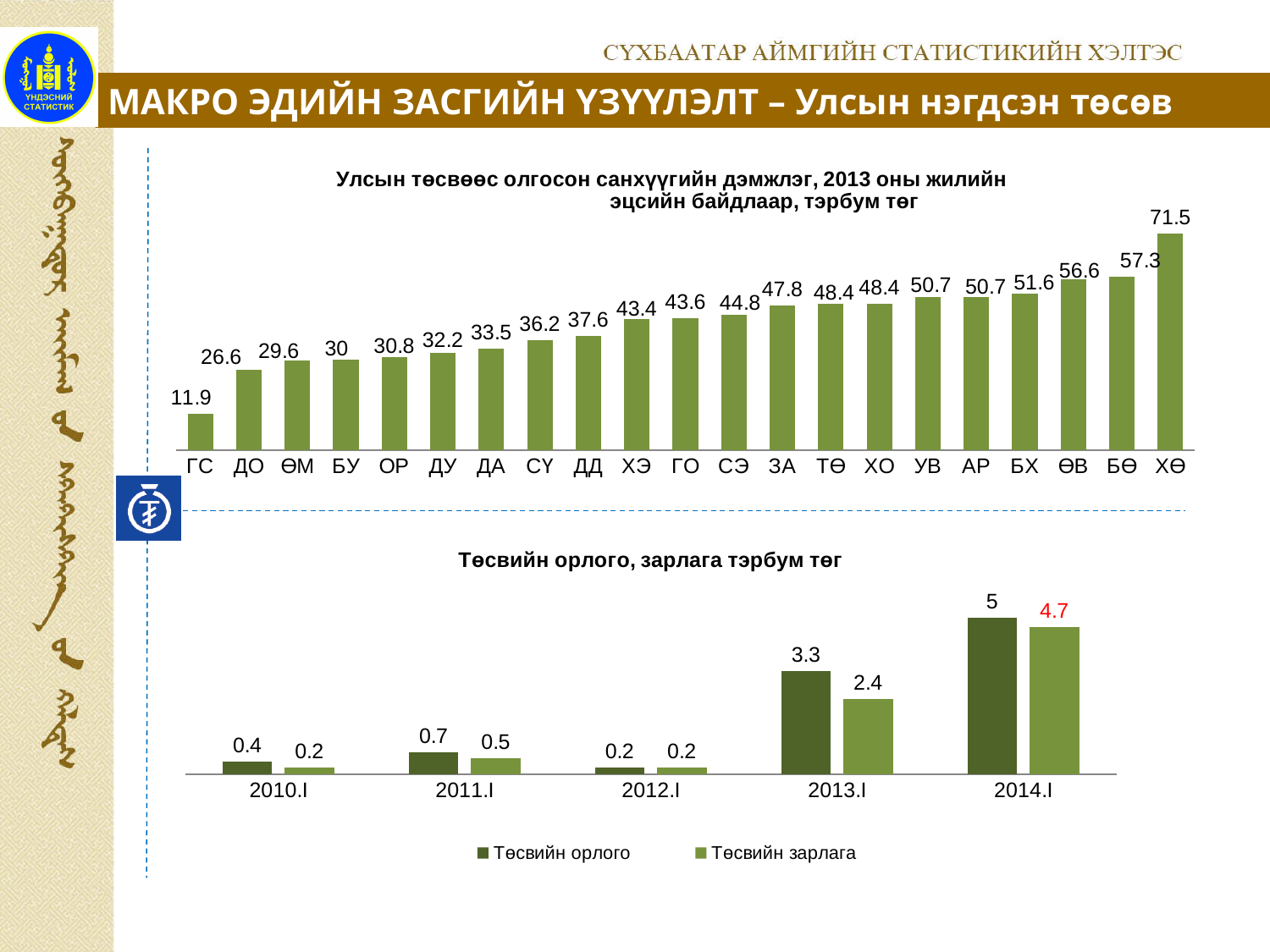
In the top chart (Улсын төсвөөс олгосон санхүүгийн дэмжлэг), which is larger, the value for ДД or the value for СЭ? СЭ In the bottom chart (Төсвийн орлого, зарлага тэрбум төг), which period has the highest Төсвийн орлого value? 2014.I In the top chart (Улсын төсвөөс олгосон санхүүгийн дэмжлэг), which category has the highest value? ХӨ What kind of chart is the bottom chart (Төсвийн орлого, зарлага тэрбум төг)? Bar chart In the bottom chart (Төсвийн орлого, зарлага тэрбум төг), what is the value of Төсвийн орлого for 2013.I? 3.3 In the top chart (Улсын төсвөөс олгосон санхүүгийн дэмжлэг), what is the difference between the values for ХӨ and ГС? 59.6 In the top chart (Улсын төсвөөс олгосон санхүүгийн дэмжлэг), which category has the lowest value? ГС In the bottom chart (Төсвийн орлого, зарлага тэрбум төг), what is the difference between Төсвийн орлого and Төсвийн зарлага for 2013.I? 0.9 In the bottom chart (Төсвийн орлого, зарлага тэрбум төг), how many series does the legend list? 2 In the top chart (Улсын төсвөөс олгосон санхүүгийн дэмжлэг), what is the value for ХЭ? 43.4 In the top chart (Улсын төсвөөс олгосон санхүүгийн дэмжлэг), how many categories are shown? 21 In the bottom chart (Төсвийн орлого, зарлага тэрбум төг), what is the value of Төсвийн зарлага for 2014.I? 4.7